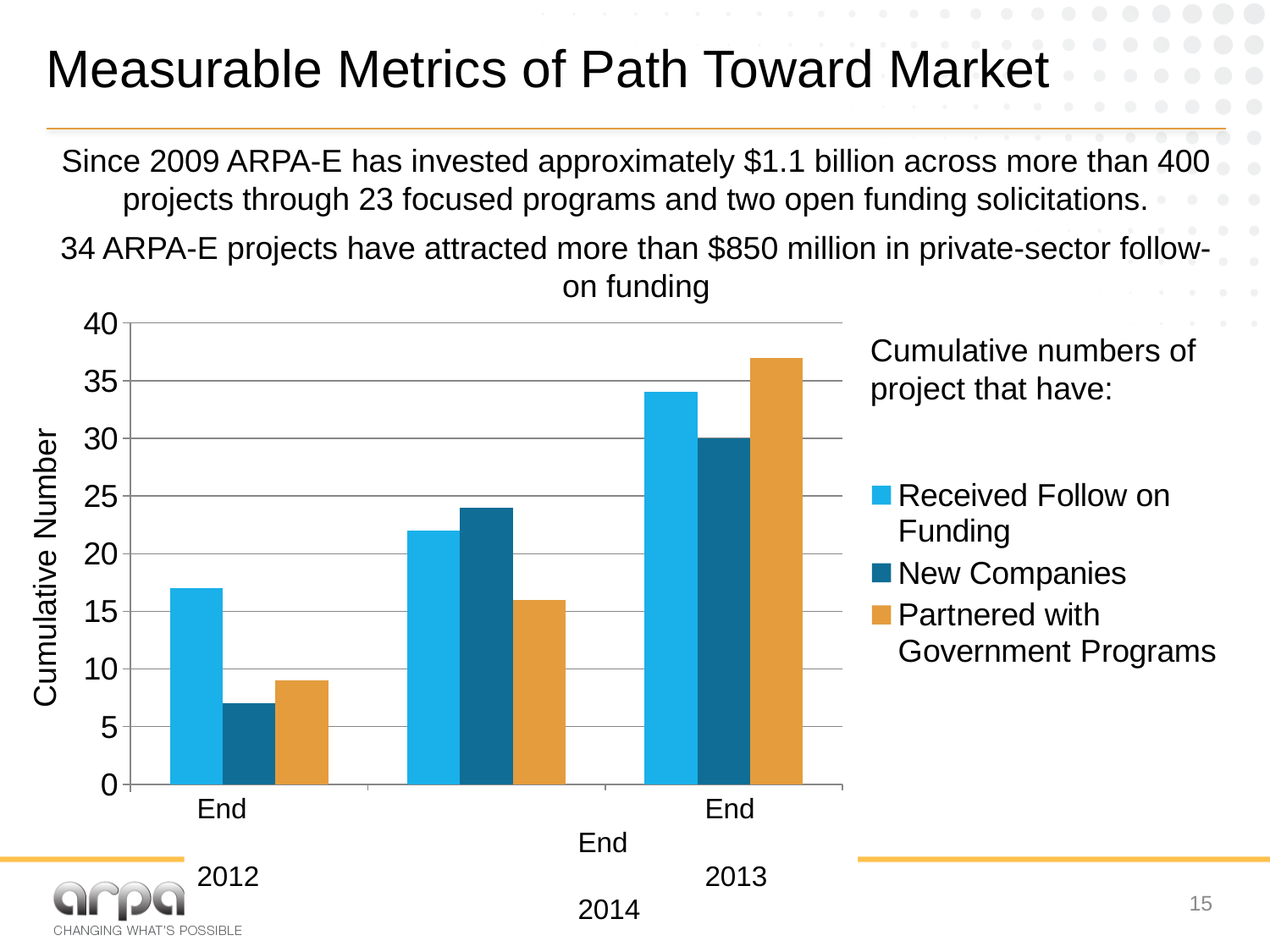
Is the New Companies value in the leftmost group greater or less than 10? less Is the Received Follow on Funding value in the leftmost group greater or less than 15? greater Is the Partnered with Government Programs value in the middle group greater or less than 20? less What is the value of the New Companies bar in the rightmost group? 30 In the middle group, which is larger: Received Follow on Funding or Partnered with Government Programs? Received Follow on Funding How many groups of bars are plotted along the x axis? 3 Do the Received Follow on Funding values rise or fall from the leftmost group to the rightmost group? rise What kind of chart is shown on the slide? bar chart In the leftmost group, which series has the lowest bar? New Companies In the rightmost group, which series has the highest bar? Partnered with Government Programs How many series does the chart's legend list? 3